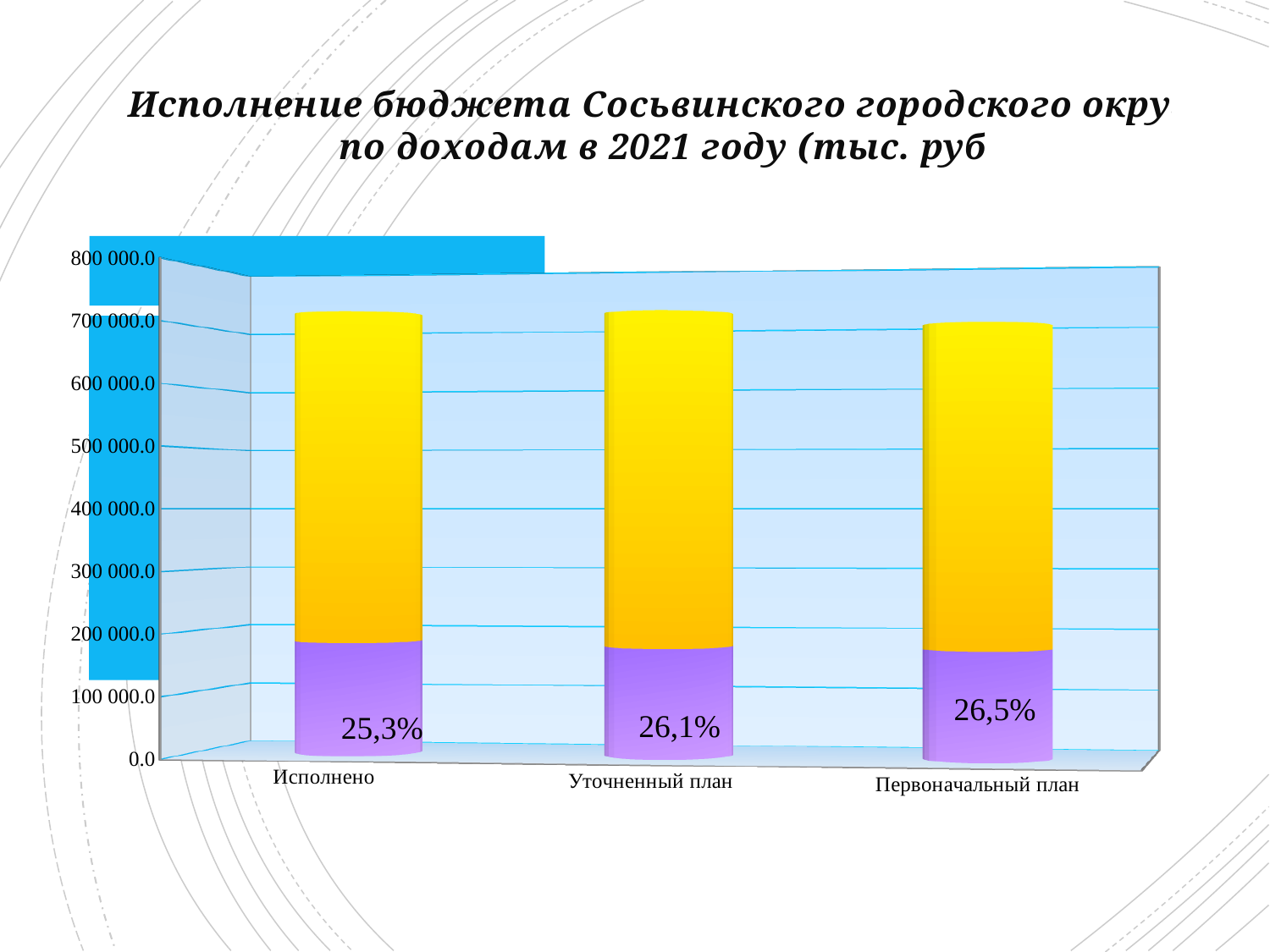
What two colours are used for the segments of the bars? purple and yellow What kind of chart is shown on the slide? bar chart What percentage label is shown on the bar for Исполнено? 25,3% How many categories are shown on the x axis of the chart? 3 Which category has the lowest percentage label? Исполнено Is the total height of the bar for Исполнено greater or less than 600 000.0? greater What percentage label is shown on the bar for Первоначальный план? 26,5% Do the percentage labels rise or fall from left to right across the categories? rise What percentage label is shown on the bar for Уточненный план? 26,1% Which category has the highest percentage label? Первоначальный план Is the purple (lower) segment of the bar for Первоначальный план greater or less than 100 000.0? greater Which has the larger percentage label, Исполнено or Уточненный план? Уточненный план